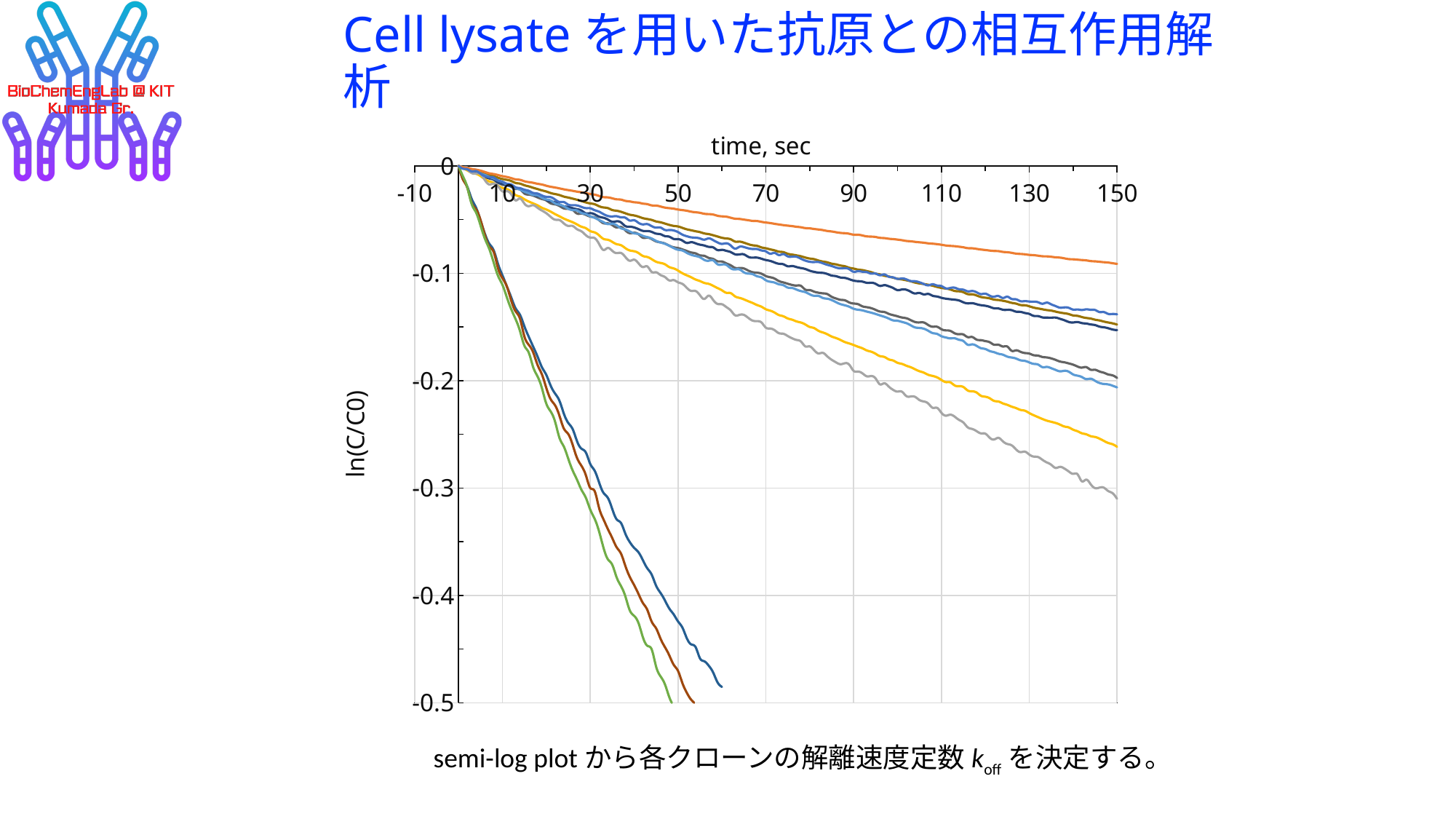
Is the value of the light grey line at 150 sec greater or less than -0.2? less What value do all the lines share at time 0 sec? 0 What is the title of the x axis of the chart? time, sec At 150 sec, which line has the lower value, the light grey line or the orange line? light grey line Is the value of the yellow line at 150 sec greater or less than -0.2? less Is the value of the orange line at 150 sec greater or less than -0.2? greater Do the plotted lines rise or fall as time increases? fall What is the title of the y axis of the chart? ln(C/C0) What kind of chart is shown on the slide? line chart At 150 sec, which line has the higher value, the orange line or the yellow line? orange line